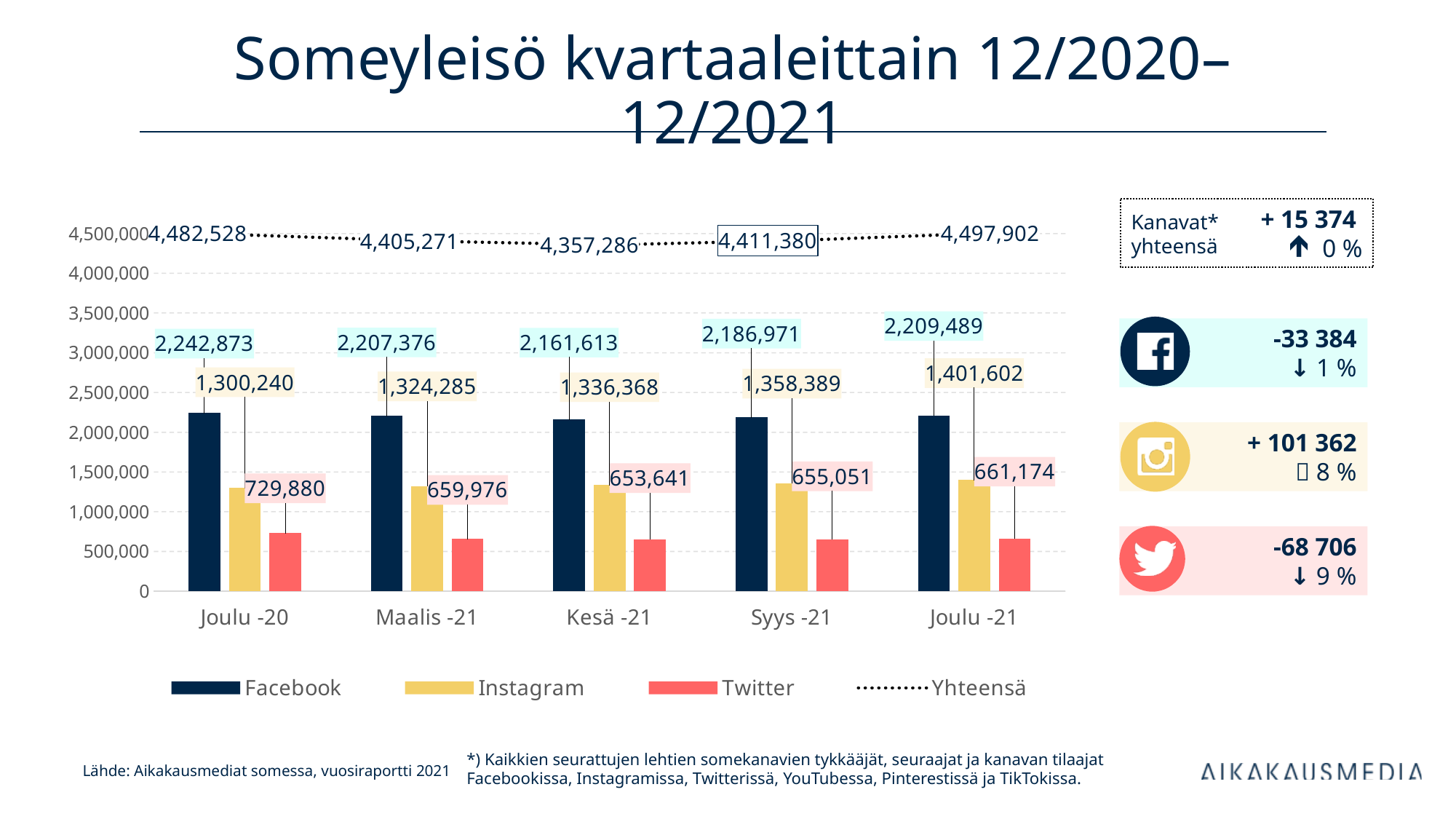
What is the Instagram value for Syys -21? 1,358,389 What is the Facebook value for Joulu -20? 2,242,873 What is the difference between the Facebook values for Joulu -20 and Joulu -21? 33,384 In which quarter is the Facebook value lowest? Kesä -21 What is the Twitter value for Maalis -21? 659,976 Does the Instagram value rise or fall from Joulu -20 to Joulu -21? rise What is the Yhteensä value for Kesä -21? 4,357,286 How many series does the legend list? 4 How many quarters are shown on the x axis? 5 Which is larger, the Twitter value for Joulu -20 or for Joulu -21? Joulu -20 In which quarter is the Yhteensä value highest? Joulu -21 In which quarter is the Instagram value highest? Joulu -21